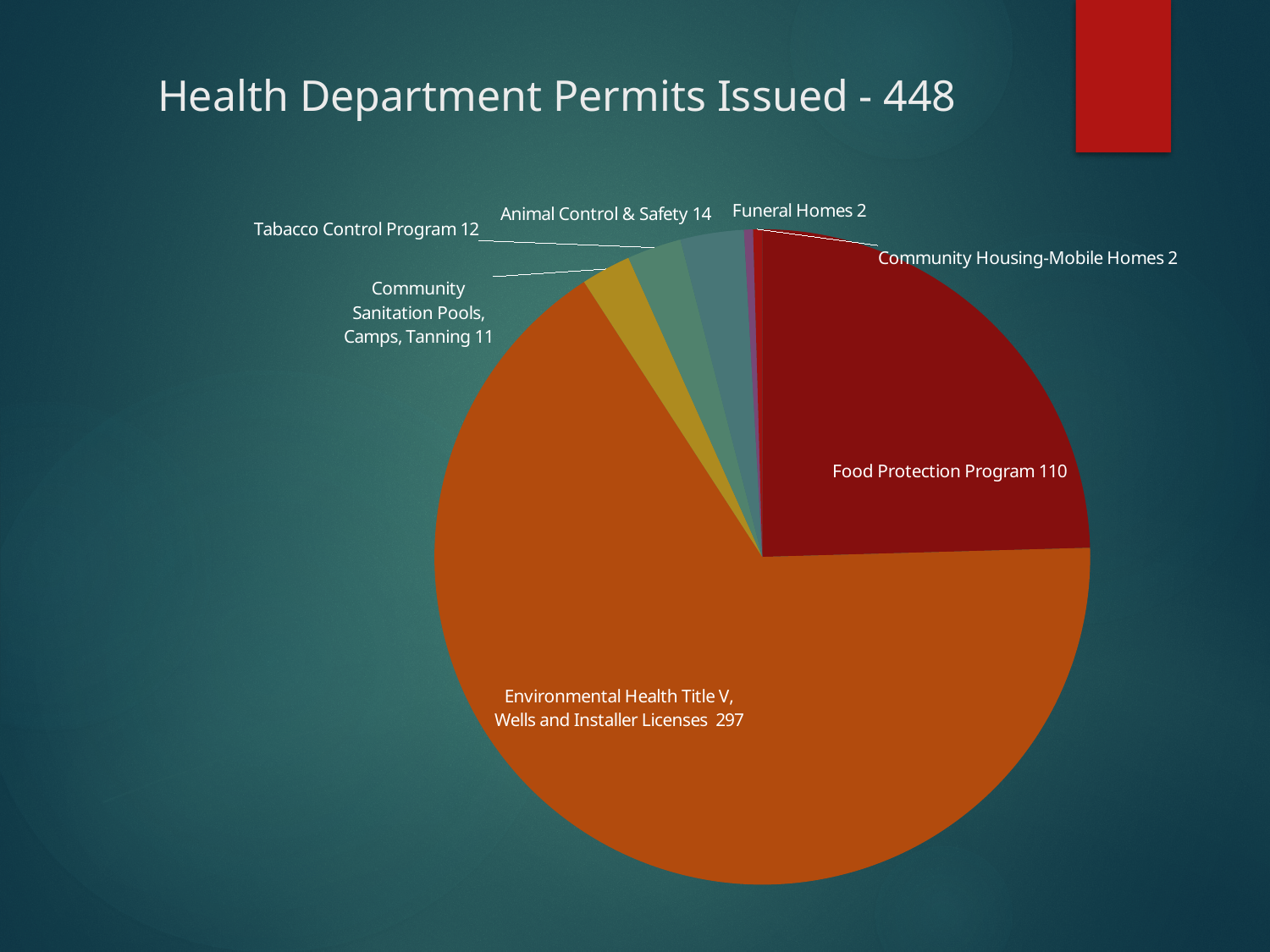
Which is larger, Animal Control & Safety or Tabacco Control Program? Animal Control & Safety What is the value for Environmental Health Title V, Wells and Installer Licenses? 297 How many permits were issued for Community Sanitation Pools, Camps, Tanning? 11 Which category has the largest slice of the pie? Environmental Health Title V, Wells and Installer Licenses How many categories are shown in the pie chart? 7 How many permits were issued under the Food Protection Program? 110 How many permits were issued for Animal Control & Safety? 14 What is the difference between the Environmental Health Title V, Wells and Installer Licenses value and the Food Protection Program value? 187 What type of chart is shown on the slide? pie chart What is the total number of Health Department permits issued according to the slide? 448 What is the value for the Tabacco Control Program? 12 What is the title of the chart on the slide? Health Department Permits Issued - 448